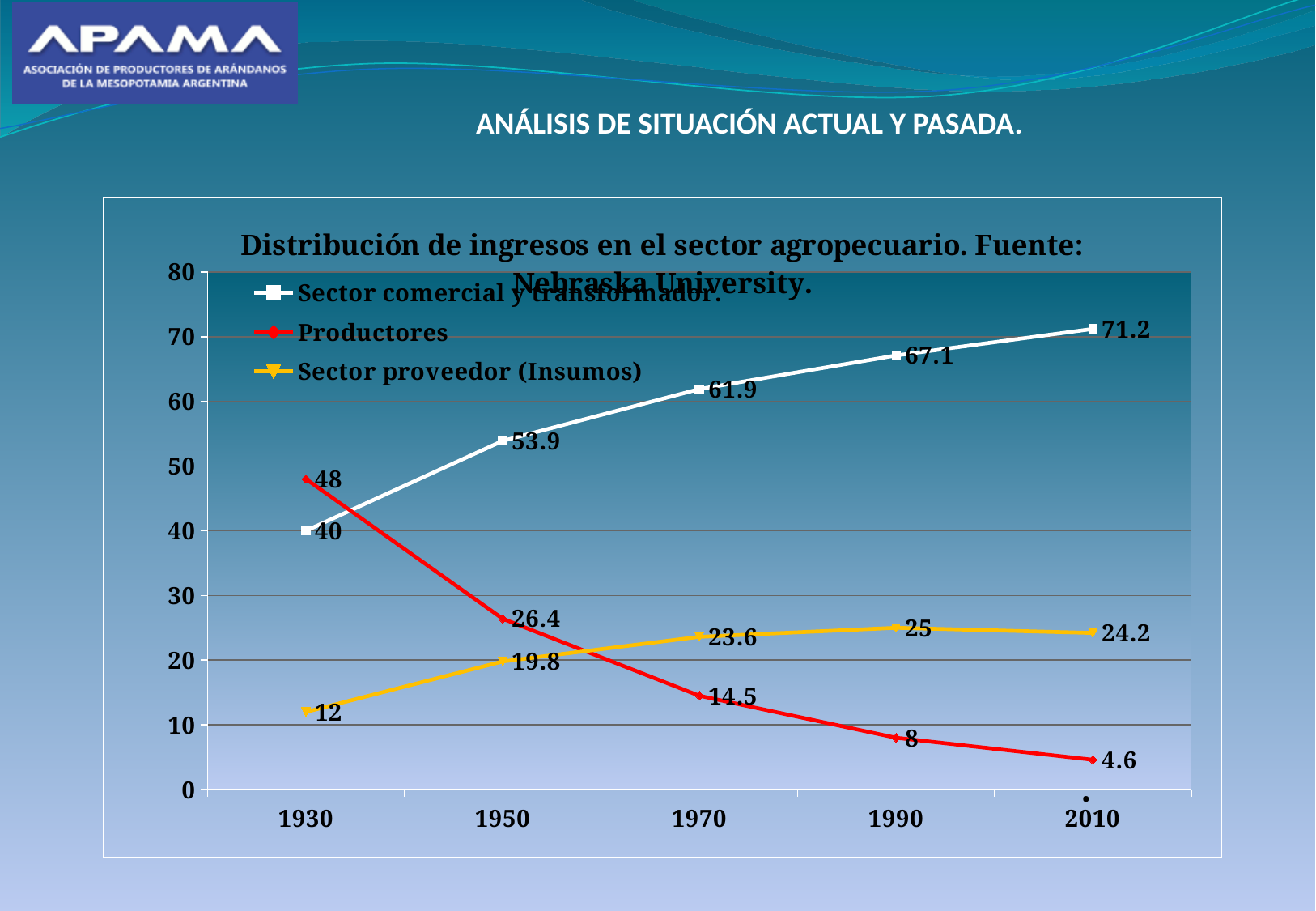
What colour is the line for Productores? Red In which year is the Sector proveedor (Insumos) series at its highest? 1990 What is the difference between the Sector comercial y transformador value in 2010 and in 1930? 31.2 What is the value for Sector comercial y transformador in 2010? 71.2 How many series does the legend list? 3 What kind of chart is shown? Line chart What is the value for Productores in 1930? 48 How many years are shown on the x axis? 5 Does the Productores series rise or fall from 1930 to 2010? Fall In which year is the Productores series at its lowest? 2010 What is the value for Sector proveedor (Insumos) in 1970? 23.6 Which is larger in 1950: Productores or Sector proveedor (Insumos)? Productores